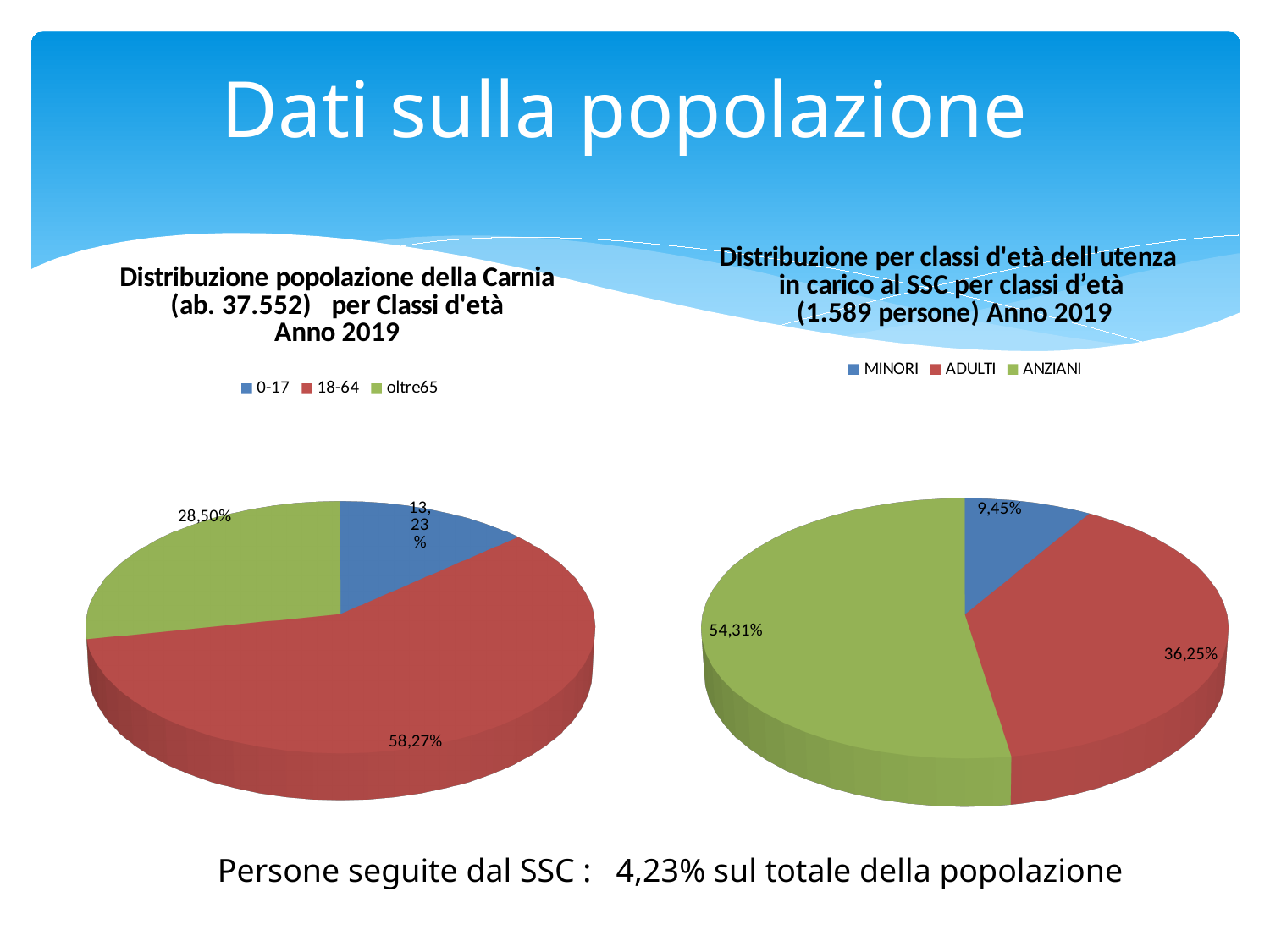
What type of chart is used for the left chart (Distribuzione popolazione della Carnia)? Pie chart In the right chart (Distribuzione per classi d'età dell'utenza in carico al SSC), what share is ADULTI? 36,25% In the left chart (Distribuzione popolazione della Carnia), what share of the population is in the oltre65 class? 28,50% How many categories does the legend of the right chart (Distribuzione per classi d'età dell'utenza in carico al SSC) list? 3 In the left chart (Distribuzione popolazione della Carnia), which age class has the smallest share? 0-17 In the left chart (Distribuzione popolazione della Carnia), which age class has the largest share? 18-64 In the right chart (Distribuzione per classi d'età dell'utenza in carico al SSC), what is the difference in percentage points between ANZIANI and ADULTI? 18,06 In the left chart (Distribuzione popolazione della Carnia), what share of the population is in the 18-64 class? 58,27% In the right chart (Distribuzione per classi d'età dell'utenza in carico al SSC), what share is MINORI? 9,45% In the left chart (Distribuzione popolazione della Carnia), what share of the population is in the 0-17 class? 13,23% In the right chart (Distribuzione per classi d'età dell'utenza in carico al SSC), which class has the largest share? ANZIANI In the right chart (Distribuzione per classi d'età dell'utenza in carico al SSC), what share is ANZIANI? 54,31%